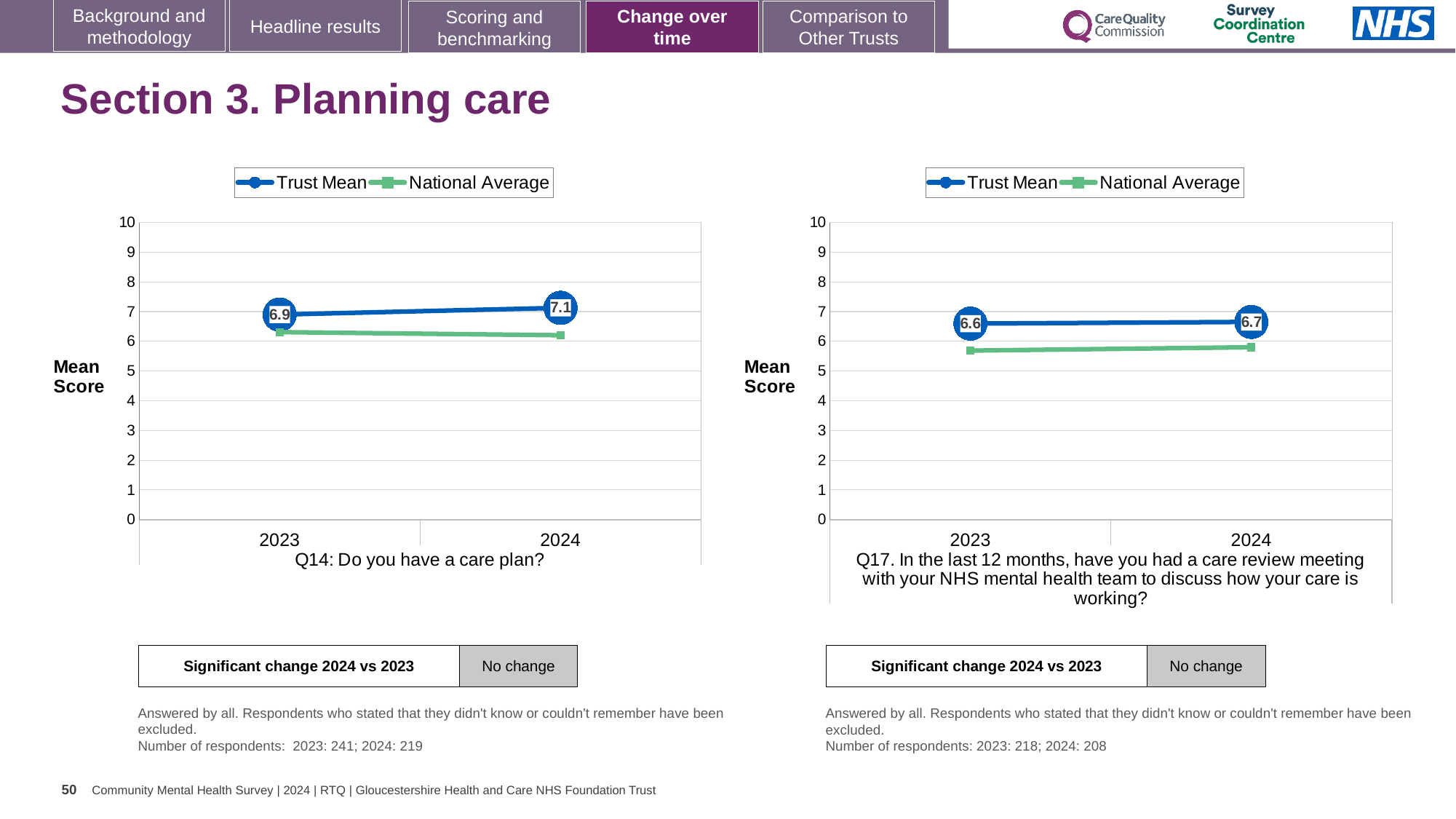
In the Q17 care review meeting chart, what is the Trust Mean for 2024? 6.7 In the Q17 care review meeting chart, is the National Average for 2023 greater or less than 6? less What kind of chart is used for Q17 care review meeting? line chart In the Q17 care review meeting chart, which series is higher in 2024, Trust Mean or National Average? Trust Mean In the Q17 care review meeting chart, what is the Trust Mean for 2023? 6.6 In the Q14 care plan chart, what is the Trust Mean for 2024? 7.1 In the Q14 care plan chart, what is the Trust Mean for 2023? 6.9 How many series does the legend of the Q14 care plan chart list? 2 How many years are plotted on the x axis of the Q14 care plan chart? 2 In the Q14 care plan chart, is the National Average for 2024 greater or less than 7? less In the Q14 care plan chart, does the Trust Mean rise or fall from 2023 to 2024? rise In the Q14 care plan chart, by how much did the Trust Mean change from 2023 to 2024? 0.2